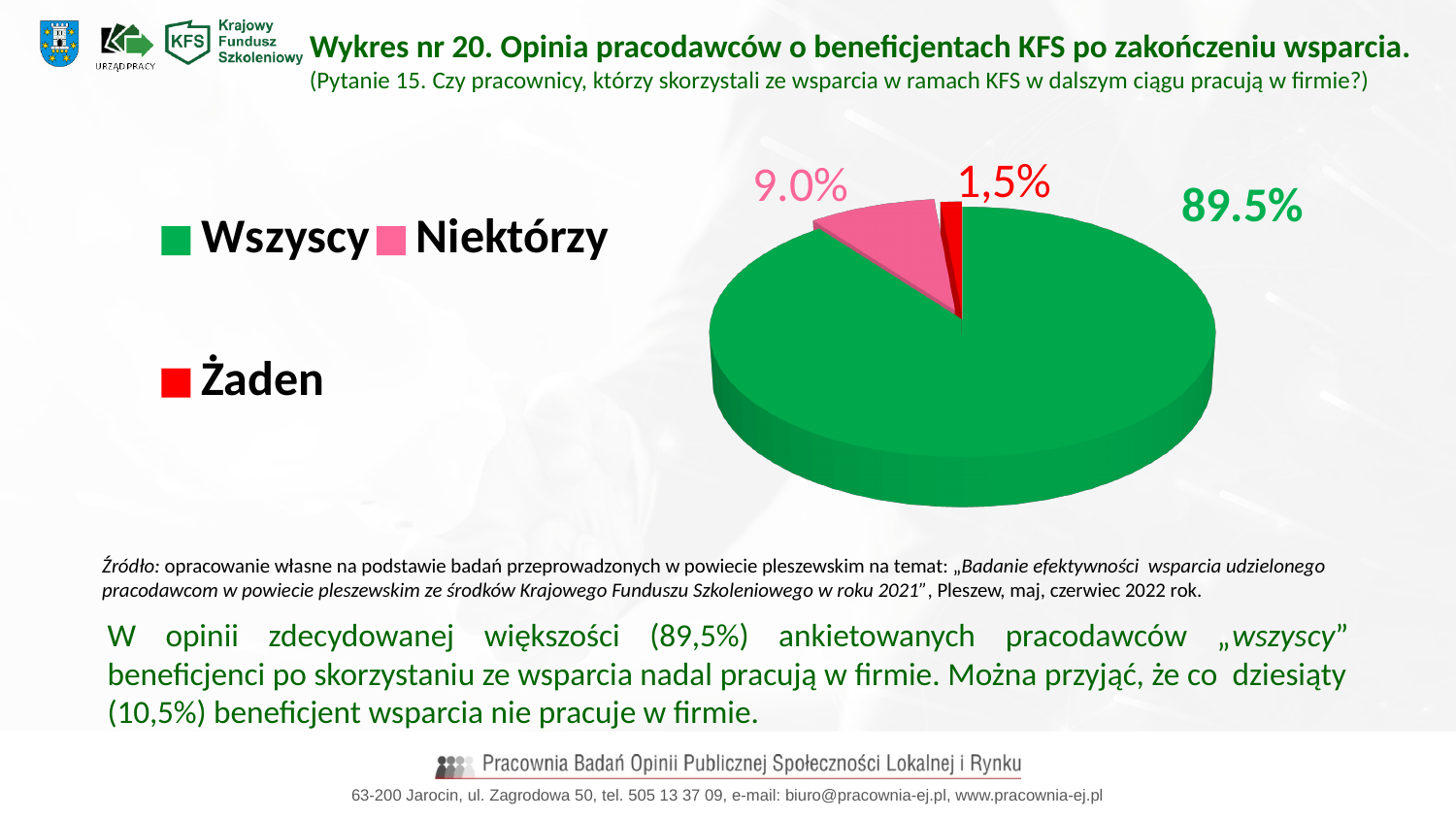
What percentage is shown for the 'Niektórzy' slice? 9.0% What type of chart is shown on the slide? Pie chart Which category has the largest share of the pie chart? Wszyscy What is the difference in percentage points between the 'Wszyscy' and 'Niektórzy' slices? 80.5 What colour is the 'Żaden' slice in the pie chart? Red Which category has the smallest share of the pie chart? Żaden What percentage of the pie chart is the 'Wszyscy' slice? 89.5% What colour is the 'Niektórzy' slice in the pie chart? Pink How many categories does the pie chart show? 3 What is the combined share of the 'Niektórzy' and 'Żaden' slices? 10.5% What percentage is shown for the 'Żaden' slice? 1,5% Which slice is larger, 'Niektórzy' or 'Żaden'? Niektórzy